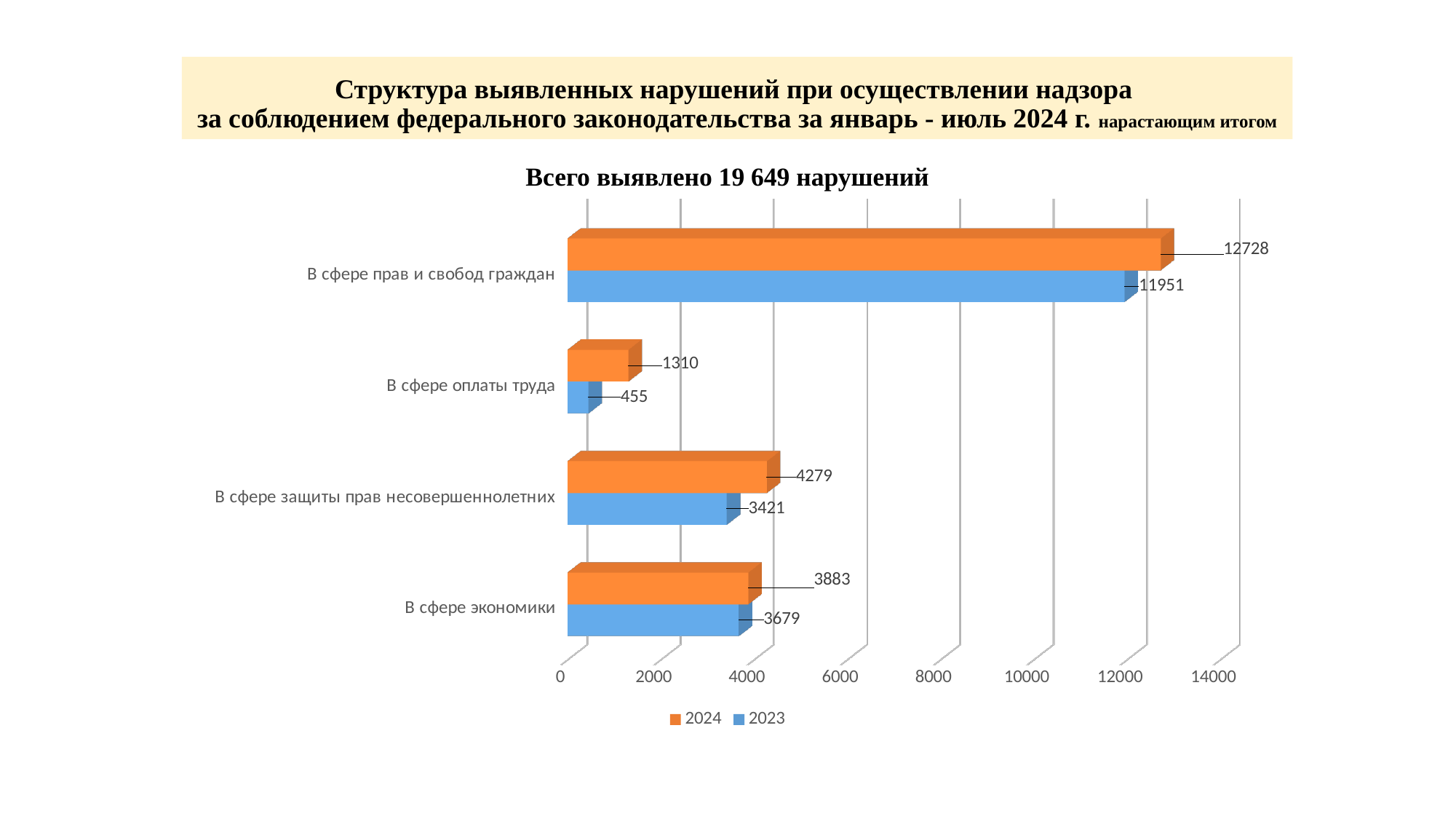
What is the 2023 value for 'В сфере оплаты труда'? 455 What kind of chart is shown on the slide? Bar chart Which category has the highest 2024 value? В сфере прав и свобод граждан What is the 2023 value for 'В сфере экономики'? 3679 What is the 2024 value for 'В сфере прав и свобод граждан'? 12728 What is the 2024 value for 'В сфере защиты прав несовершеннолетних'? 4279 Which is larger: the 2024 value for 'В сфере защиты прав несовершеннолетних' or the 2024 value for 'В сфере экономики'? В сфере защиты прав несовершеннолетних How many categories are shown on the chart? 4 What is the difference between the 2024 and 2023 values for 'В сфере оплаты труда'? 855 Which category has the lowest 2023 value? В сфере оплаты труда How many series does the legend list? 2 What is the difference between the 2024 and 2023 values for 'В сфере прав и свобод граждан'? 777